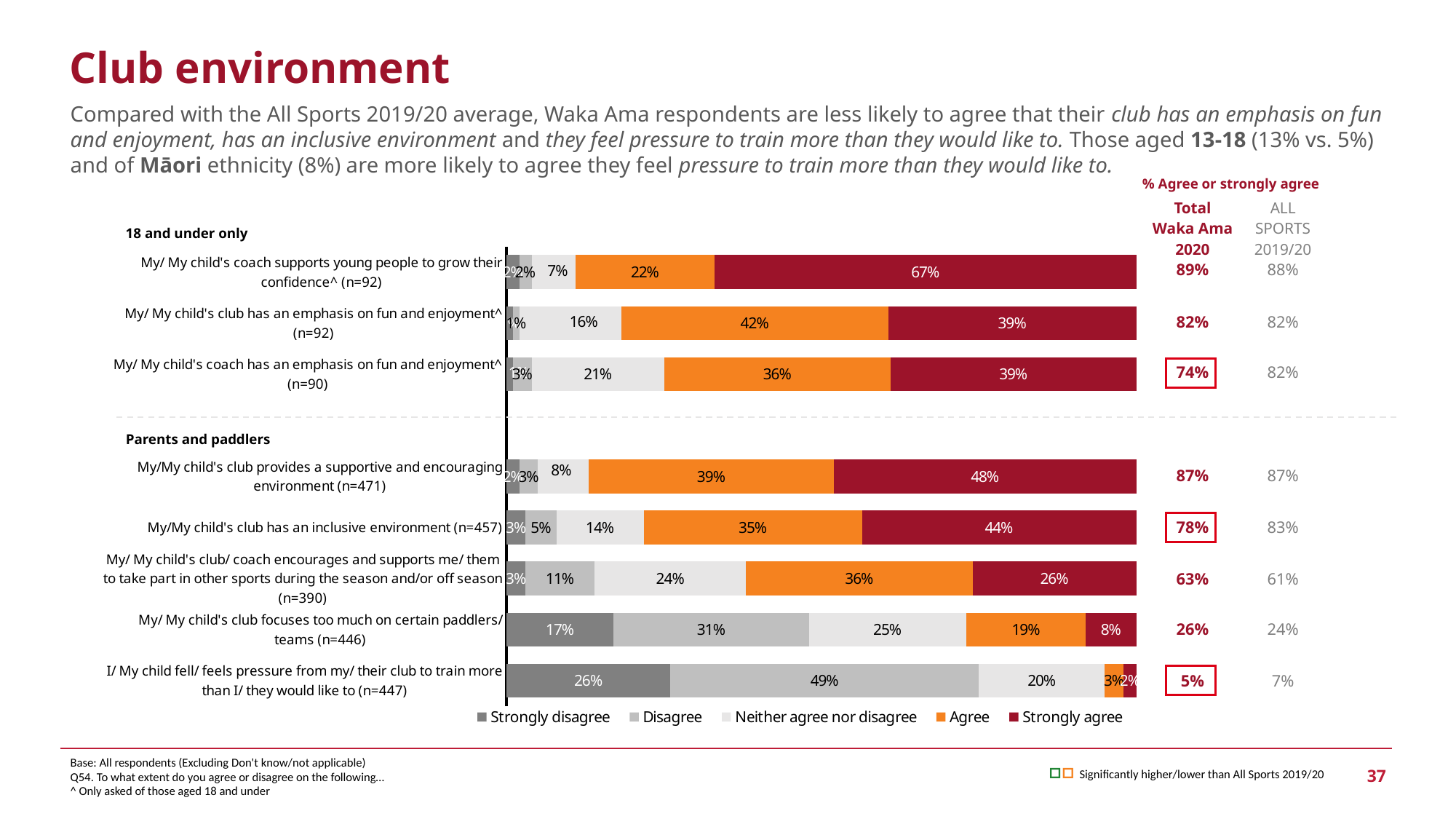
What percentage agree (not strongly agree) that their club has an emphasis on fun and enjoyment? 42% What percentage disagree that they feel pressure from their club to train more than they would like to? 49% How many statements are plotted in the chart? 8 What is the Total Waka Ama 2020 '% Agree or strongly agree' figure for 'club has an inclusive environment'? 78% What type of chart is shown on the slide? Stacked bar chart How many response categories does the legend list? 5 Which statement has the highest 'Strongly agree' percentage? My/ My child's coach supports young people to grow their confidence What percentage strongly disagree that their club focuses too much on certain paddlers/teams? 17% Which has a higher 'Strongly agree' percentage: 'club provides a supportive and encouraging environment' or 'club has an inclusive environment'? Club provides a supportive and encouraging environment What percentage strongly agree that their coach supports young people to grow their confidence? 67% Which statement has the lowest 'Strongly agree' percentage? I/ My child fell/ feels pressure from my/ their club to train more than I/ they would like to For 'club focuses too much on certain paddlers/teams', how many percentage points higher is 'Agree' than 'Strongly agree'? 11 percentage points